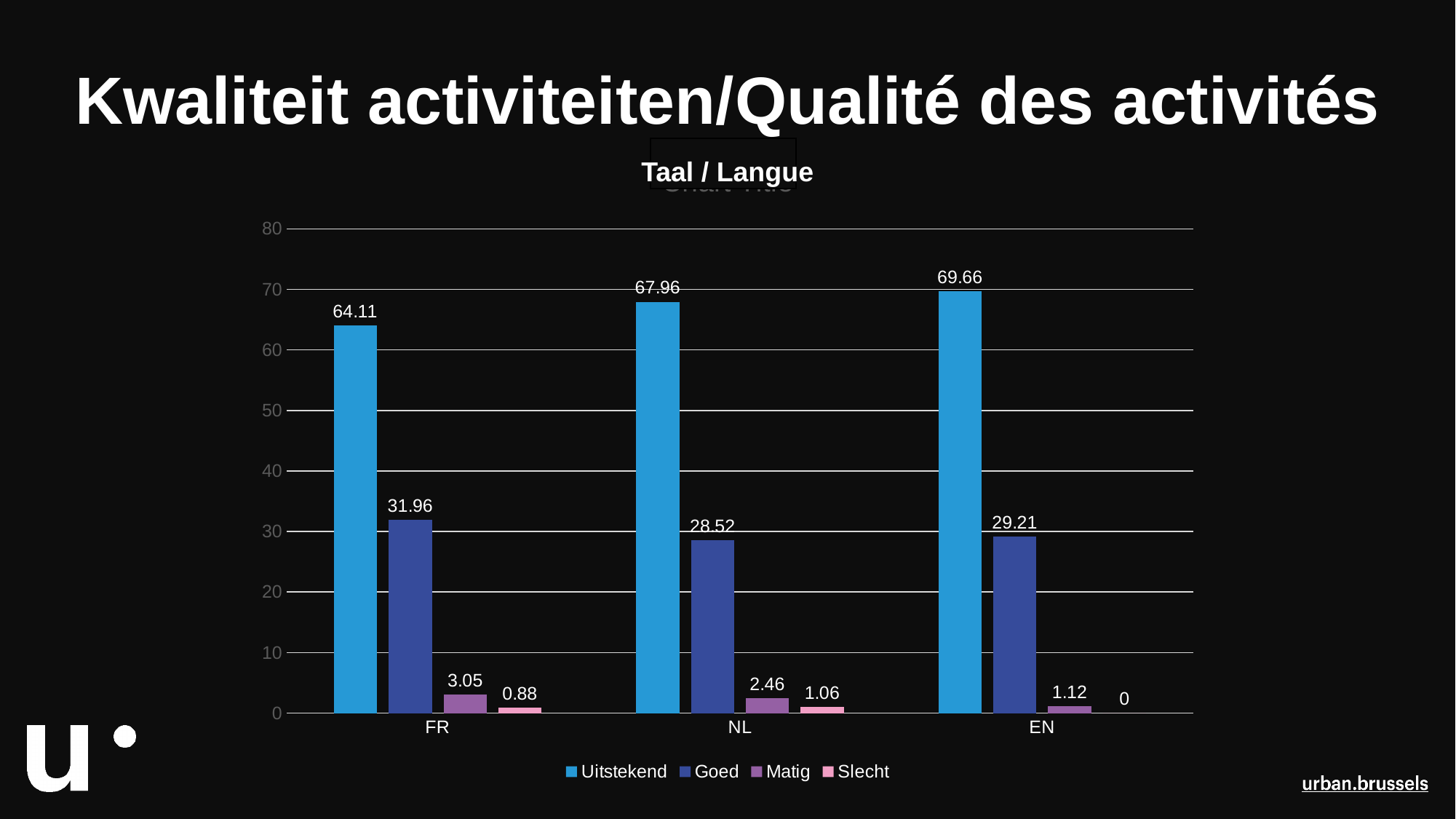
How many language categories are shown on the x axis? 3 How many series does the legend list? 4 Is the Uitstekend value for NL greater or less than 60? greater Is the Goed value for FR larger than the Goed value for EN? Yes What is the Goed value for NL? 28.52 What kind of chart is shown on the slide? Bar chart What is the Matig value for NL? 2.46 Which language has the lowest Goed value? NL Which language has the highest Uitstekend value? EN What is the difference between the Uitstekend values for EN and FR? 5.55 What is the Slecht value for EN? 0 What is the Uitstekend value for FR? 64.11